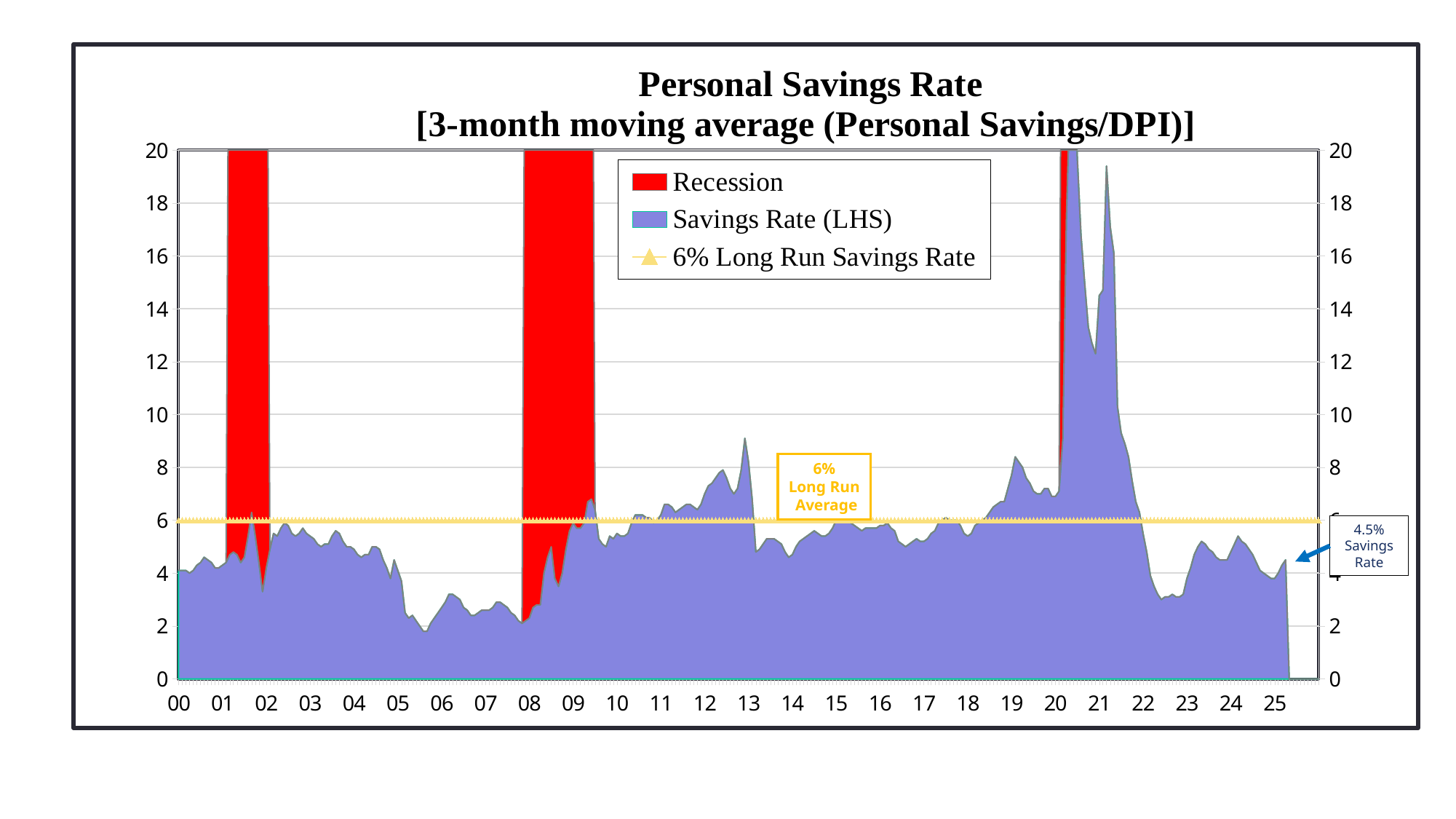
What kind of chart is shown on the slide? area chart Is the most recent savings rate (4.5%) greater or less than the 6% long run average? less What is the title of the chart? Personal Savings Rate [3-month moving average (Personal Savings/DPI)] By how much is the 6% long run average above the most recent 4.5% savings rate? 1.5% What is the long run savings rate shown by the horizontal line? 6% How many recession periods are shaded on the chart? 3 How many series does the legend list? 3 Is the peak savings rate in 2020 greater or less than 18? greater Is the savings rate in 2006 greater or less than 4? less In which year does the savings rate reach its highest peak? 2020 What is the most recent savings rate value annotated on the chart? 4.5% What colour is used to mark recession periods? red